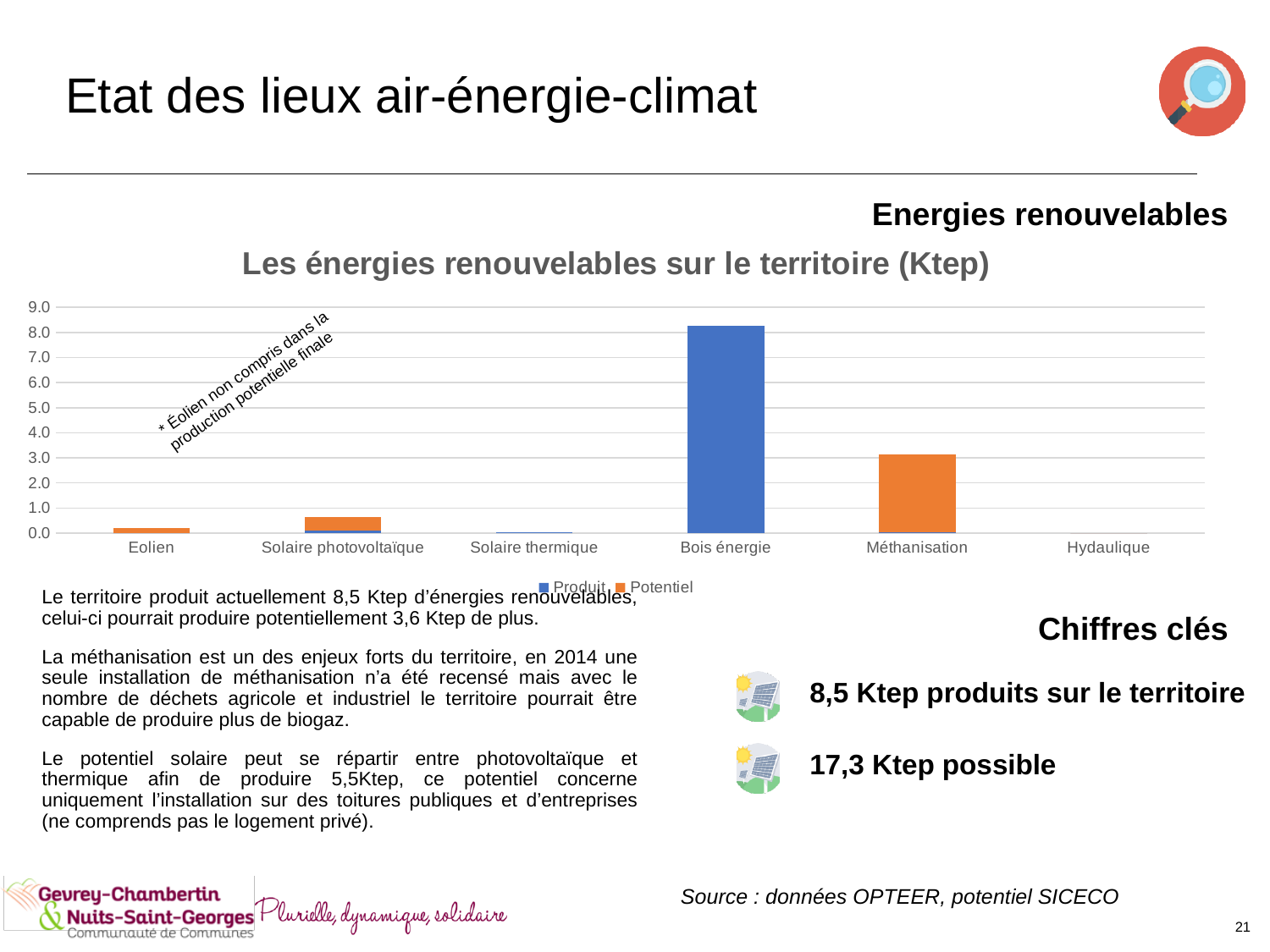
Which is larger: the Produit value for Bois énergie or the Potentiel value for Méthanisation? Produit value for Bois énergie Is the Potentiel value for Méthanisation greater or less than 4.0? less Is the Potentiel value for Méthanisation greater or less than 2.0? greater Which series is shown in orange in the chart? Potentiel Which category has the highest Produit value? Bois énergie How many categories are shown on the x axis of the chart? 6 Which category has the highest Potentiel value? Méthanisation Is the Produit value for Bois énergie greater or less than 8.0? greater What kind of chart is shown on the slide? bar chart What is the title of the chart? Les énergies renouvelables sur le territoire (Ktep) How many series does the chart legend list? 2